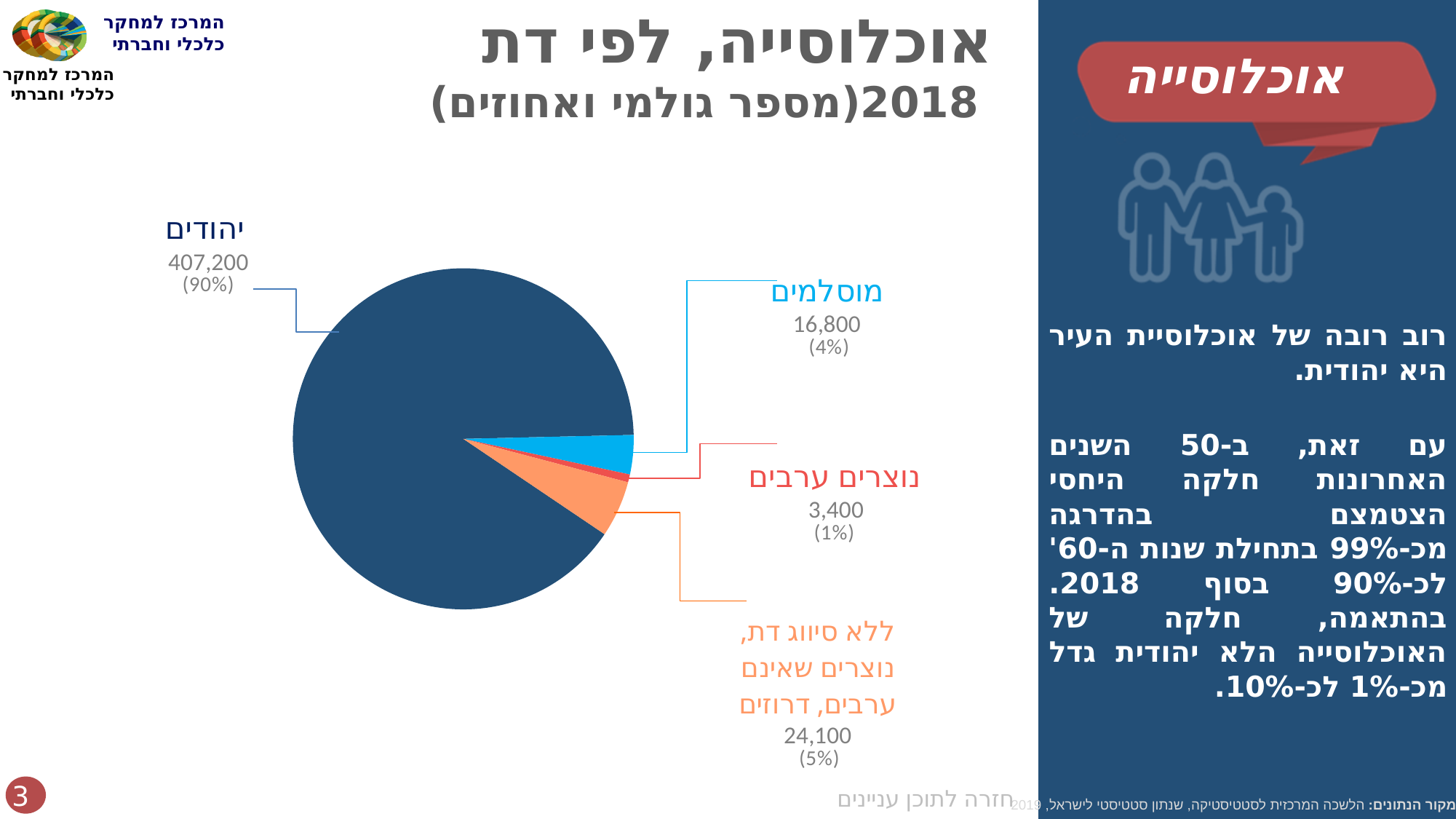
Which category has the smallest slice in the pie chart? נוצרים ערבים What percentage share is shown for יהודים (Jews)? 90% What year does the chart title say the data is for? 2018 What is the value shown for the slice labelled ללא סיווג דת, נוצרים שאינם ערבים, דרוזים? 24,100 What kind of chart is shown on the slide? Pie chart What percentage share is shown for מוסלמים (Muslims)? 4% What is the value shown for נוצרים ערבים (Arab Christians)? 3,400 What is the difference between the value for מוסלמים (16,800) and the value for נוצרים ערבים (3,400)? 13,400 Which is larger, the value for מוסלמים or the value for ללא סיווג דת, נוצרים שאינם ערבים, דרוזים? ללא סיווג דת, נוצרים שאינם ערבים, דרוזים How many slices does the pie chart have? 4 Which category has the largest slice in the pie chart? יהודים What is the value shown for יהודים (Jews) in the pie chart? 407,200